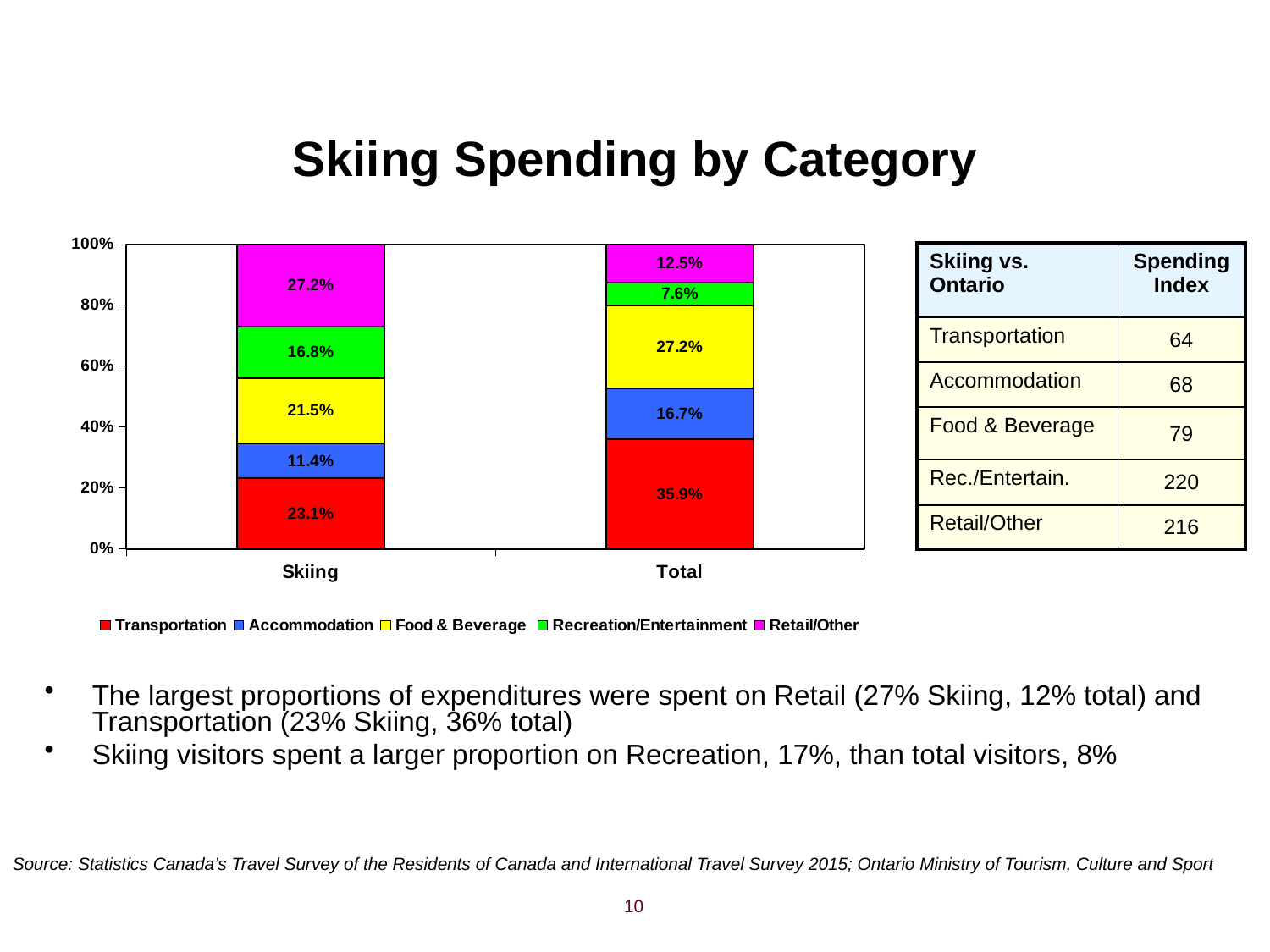
Which is larger: the Recreation/Entertainment share for Skiing or for Total? Skiing What percentage of Total spending went to Transportation? 35.9% What percentage of Skiing spending went to Transportation? 23.1% How many bars are plotted in the chart? 2 Which category has the smallest share in the Total bar? Recreation/Entertainment How many series does the legend list? 5 What is the Retail/Other share for the Skiing bar? 27.2% What kind of chart is shown on the slide? Stacked bar chart What is the Recreation/Entertainment share for the Total bar? 7.6% What is the difference between the Transportation share for Total and for Skiing? 12.8% What is the Accommodation share for the Total bar? 16.7% Which category has the largest share in the Skiing bar? Retail/Other